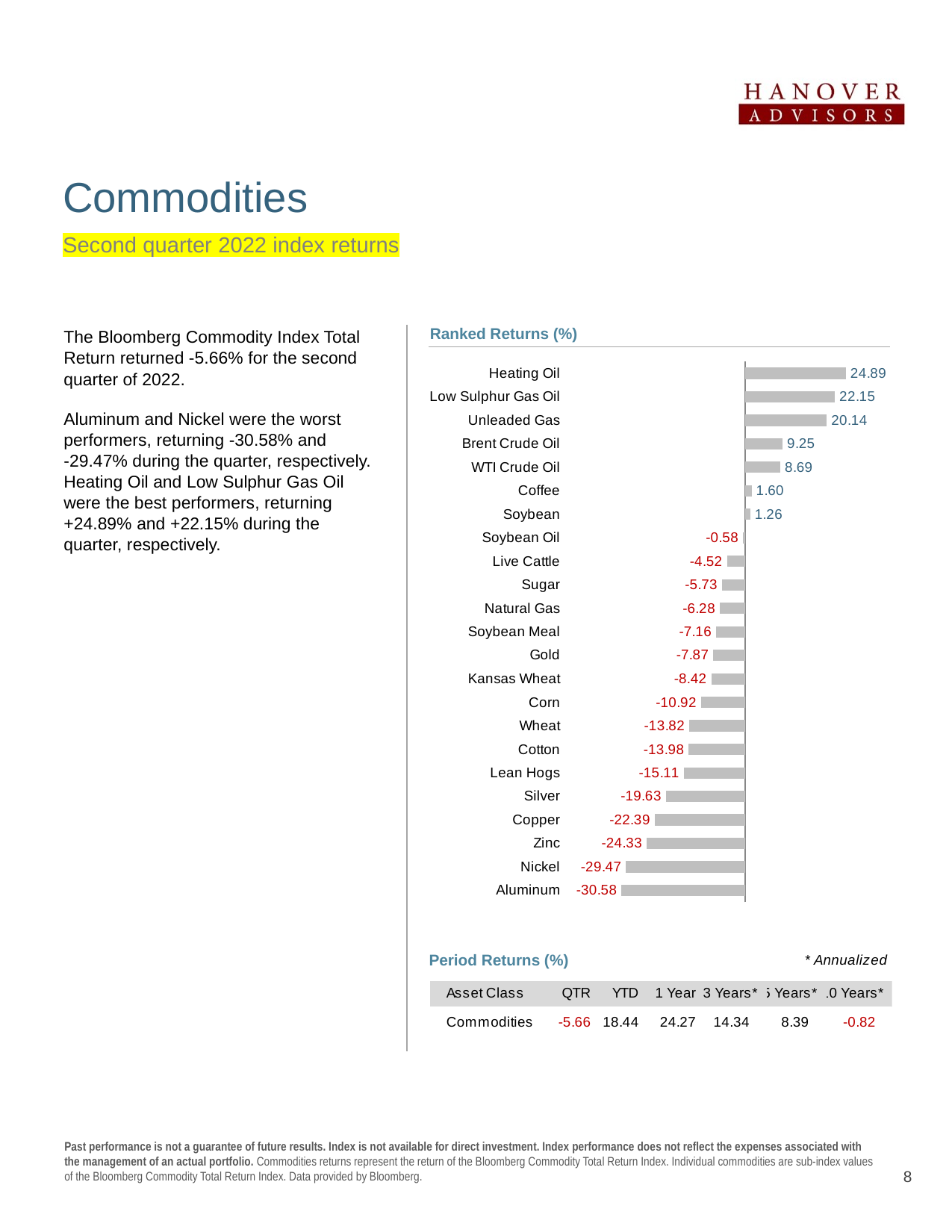
How many commodities are shown in the Ranked Returns chart? 23 Which has the higher ranked return, Silver or Lean Hogs? Lean Hogs What is the ranked return for Copper? -22.39 Which has the lower ranked return, Nickel or Zinc? Nickel What type of chart is the Ranked Returns chart? Bar chart What is the ranked return for Heating Oil? 24.89 Which commodity has the highest ranked return? Heating Oil What is the ranked return for Gold? -7.87 What is the title of the chart? Ranked Returns (%) What is the difference between the ranked returns of Brent Crude Oil and WTI Crude Oil? 0.56 Which commodity has the lowest ranked return? Aluminum What is the difference between the ranked returns of Heating Oil and Low Sulphur Gas Oil? 2.74